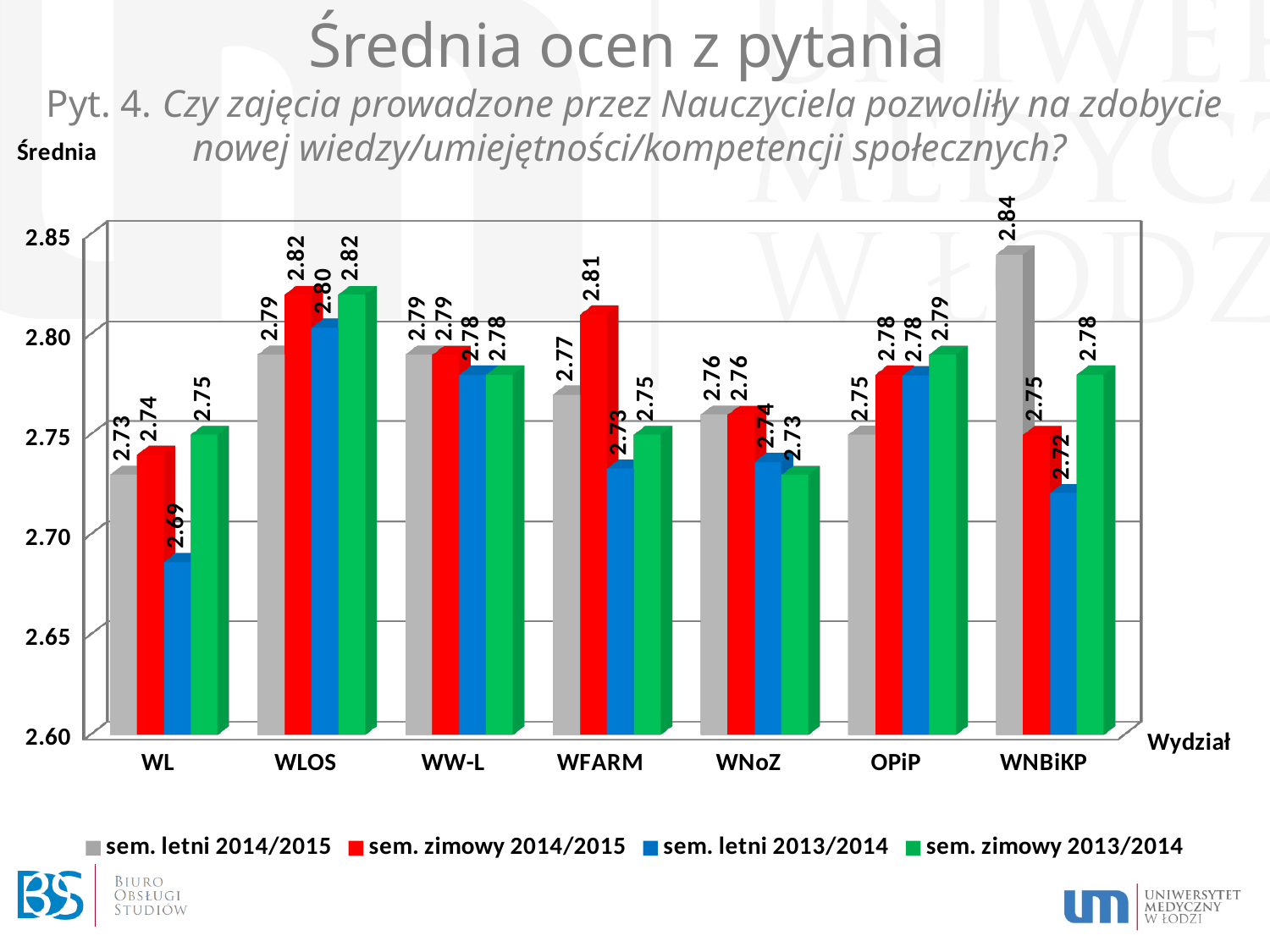
Which category has the lowest value in the sem. letni 2013/2014 series? WL Which colour represents the sem. zimowy 2013/2014 series? green How many series does the legend list? 4 What is the value for OPiP in the sem. zimowy 2013/2014 series? 2.79 How many categories (Wydział) are shown on the x axis? 7 What is the value for WFARM in the sem. zimowy 2014/2015 series? 2.81 Which is larger for WFARM: the sem. zimowy 2014/2015 value or the sem. letni 2013/2014 value? sem. zimowy 2014/2015 What is the difference between the sem. letni 2014/2015 value and the sem. zimowy 2014/2015 value for WNBiKP? 0.09 Which category has the highest value in the sem. letni 2014/2015 series? WNBiKP What is the value for WL in the sem. letni 2013/2014 series? 2.69 What is the value for WNBiKP in the sem. letni 2014/2015 series? 2.84 What kind of chart is shown on the slide? bar chart